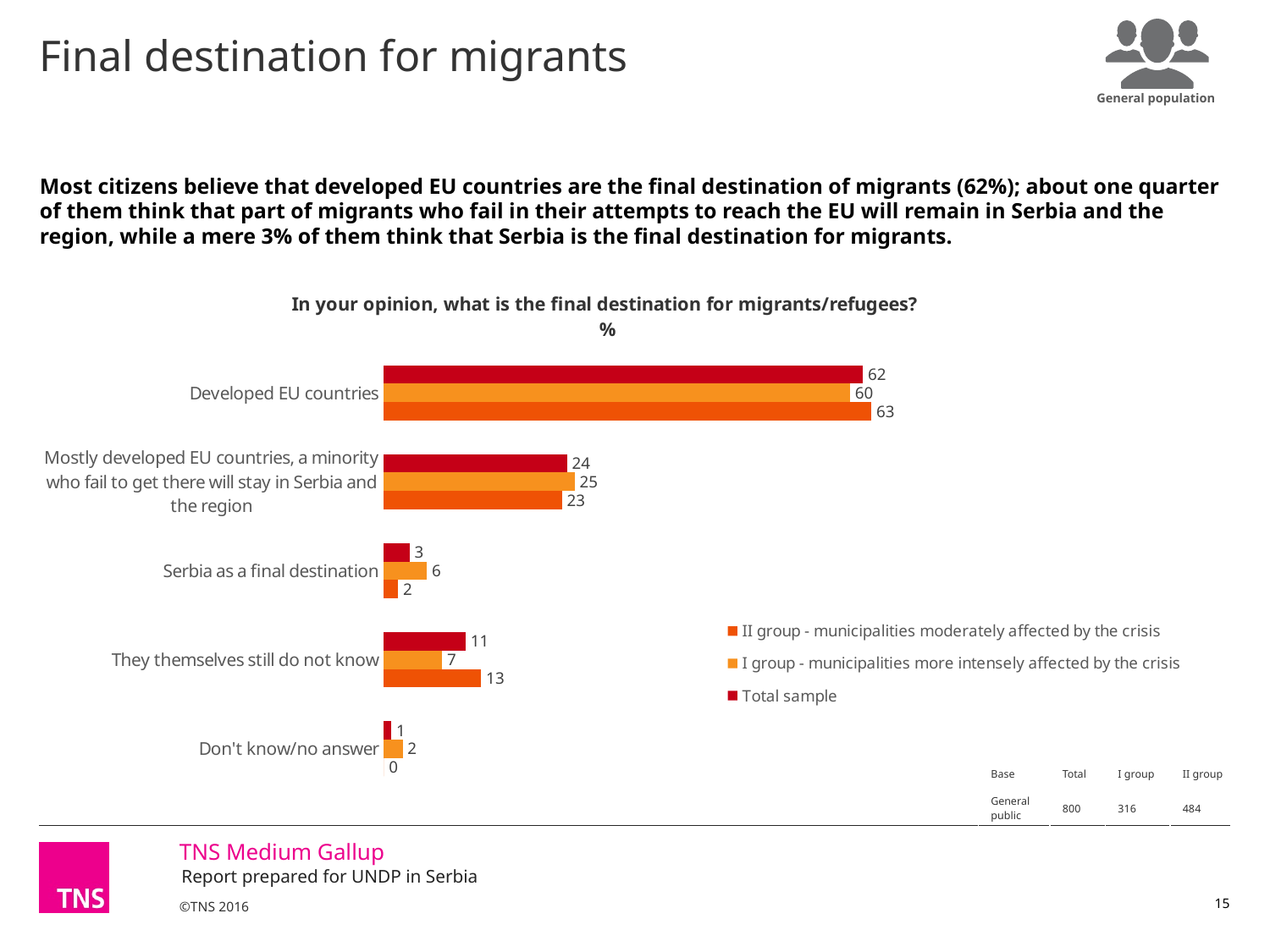
What is the Total sample value for "Developed EU countries"? 62 What is the value for "They themselves still do not know" in the II group (municipalities moderately affected by the crisis)? 13 Which category has the highest Total sample value? Developed EU countries What is the II group value for "Don't know/no answer"? 0 What is the value for "Serbia as a final destination" in the I group (municipalities more intensely affected by the crisis)? 6 Which category has the lowest Total sample value? Don't know/no answer For "They themselves still do not know", which is larger: the Total sample value or the I group value? Total sample How many series does the legend list? 3 What is the difference between the II group and I group values for "Developed EU countries"? 3 What is the title of the chart? In your opinion, what is the final destination for migrants/refugees? What kind of chart is shown on the slide? Bar chart How many categories are shown on the chart? 5